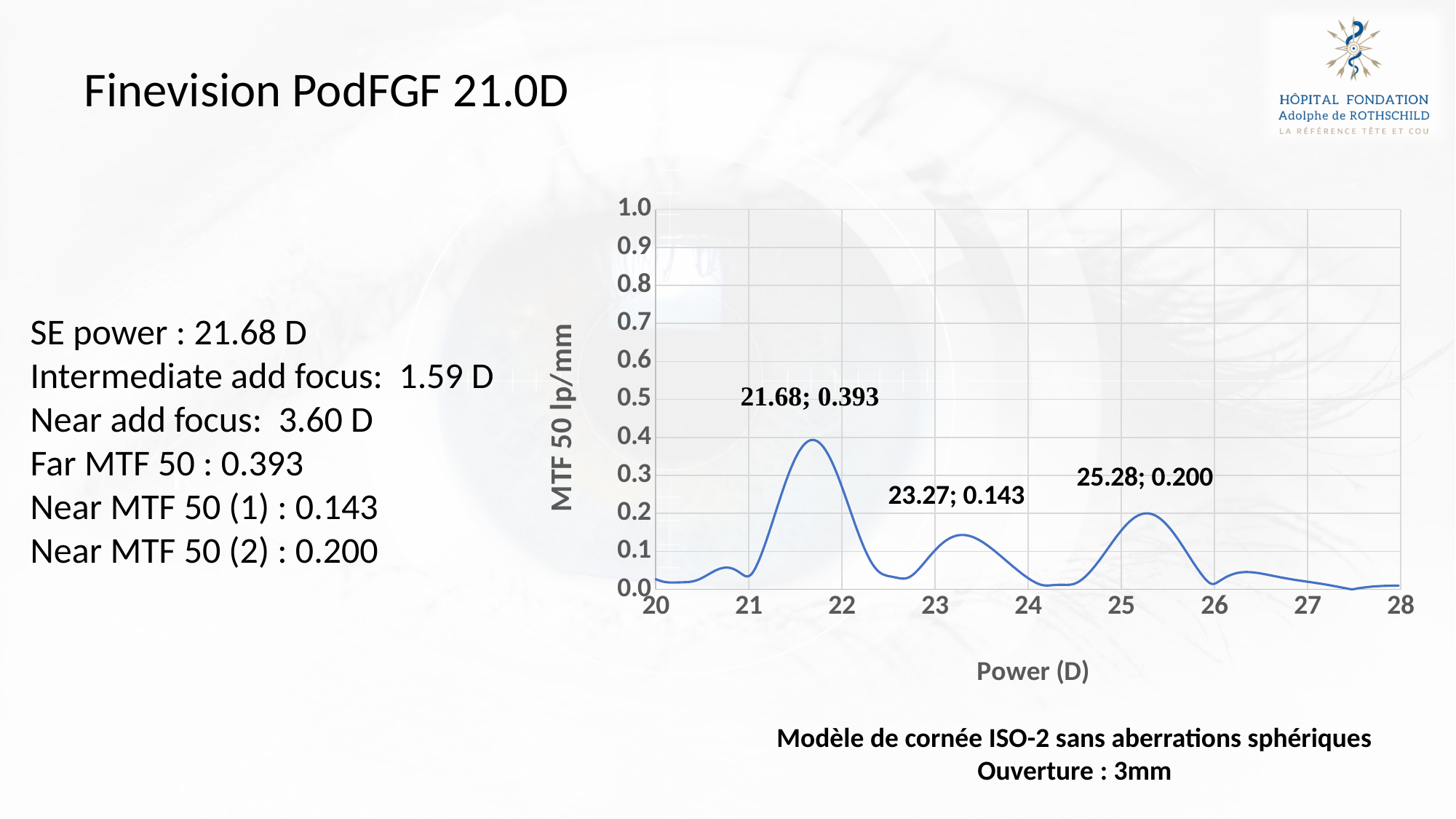
What is the label of the x axis of the chart? Power (D) What is the difference in MTF 50 between the peak at 25.28 D and the peak at 23.27 D? 0.057 Is the MTF 50 value at the peak near 21.68 D greater or less than 0.5? less Which of the three labelled peaks has the lowest MTF 50 value? 23.27; 0.143 What is the difference in MTF 50 between the peak at 21.68 D and the peak at 25.28 D? 0.193 What is the MTF 50 value at the peak labelled at 25.28 D? 0.200 What is the MTF 50 value at the peak labelled at 21.68 D? 0.393 What kind of chart is shown on the slide? line chart How many labelled peaks are marked on the curve? 3 What is the MTF 50 value at the peak labelled at 23.27 D? 0.143 Which labelled peak is higher: the one at 23.27 D or the one at 25.28 D? 25.28 D At which power (D) does the highest labelled peak of the curve occur? 21.68